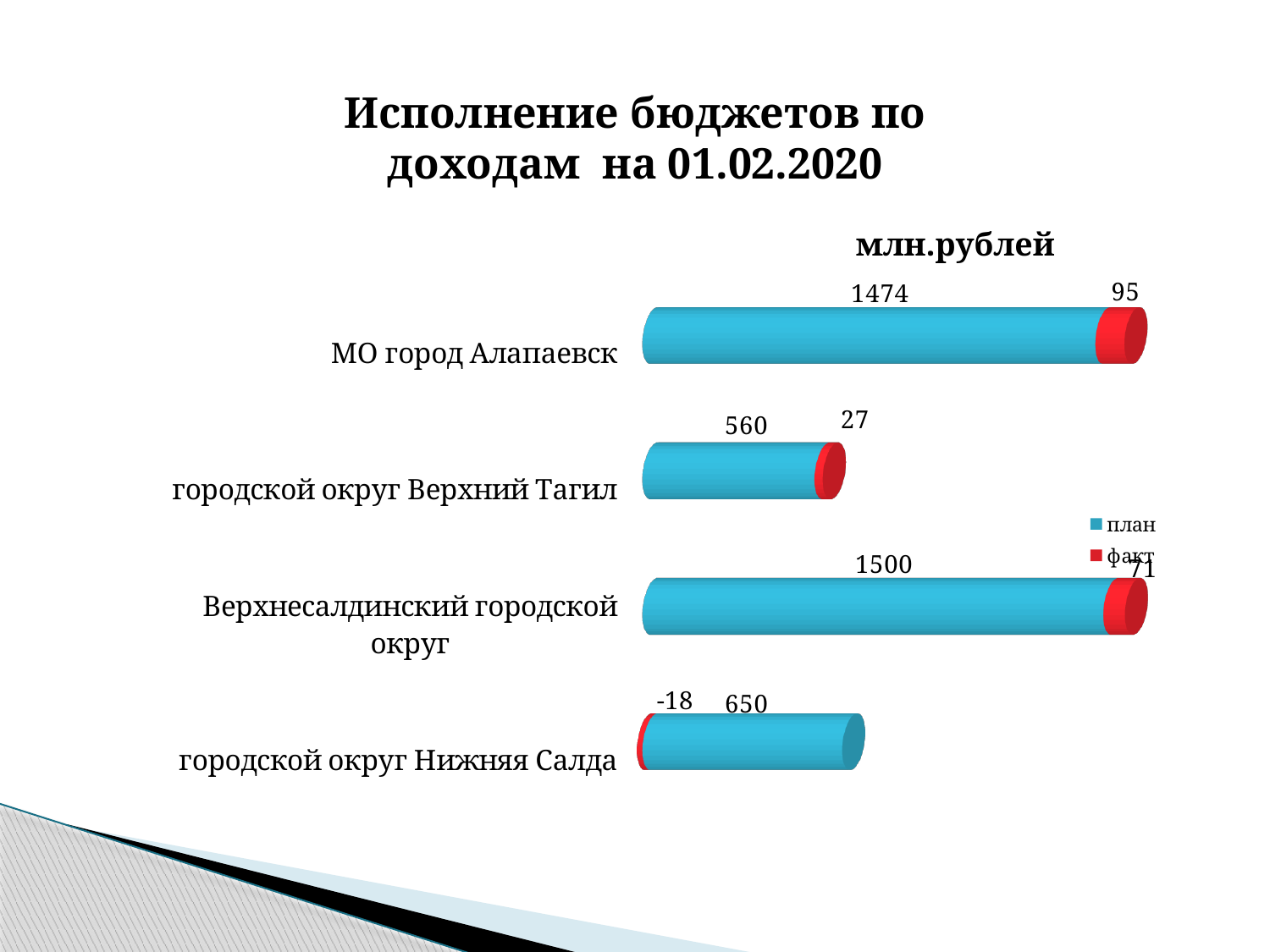
Which category has the lowest план value? городской округ Верхний Тагил Which is larger, the план value for городской округ Нижняя Салда or for городской округ Верхний Тагил? городской округ Нижняя Салда How many categories are shown in the chart? 4 What is the факт value for городской округ Верхний Тагил? 27 Which category has the highest план value? Верхнесалдинский городской округ Which category has the lowest факт value? городской округ Нижняя Салда What is the план value for МО город Алапаевск? 1474 What is the факт value for городской округ Нижняя Салда? -18 What kind of chart is shown on the slide? bar chart What is the difference between the план values for Верхнесалдинский городской округ and МО город Алапаевск? 26 How many series does the legend list? 2 What is the план value for городской округ Нижняя Салда? 650